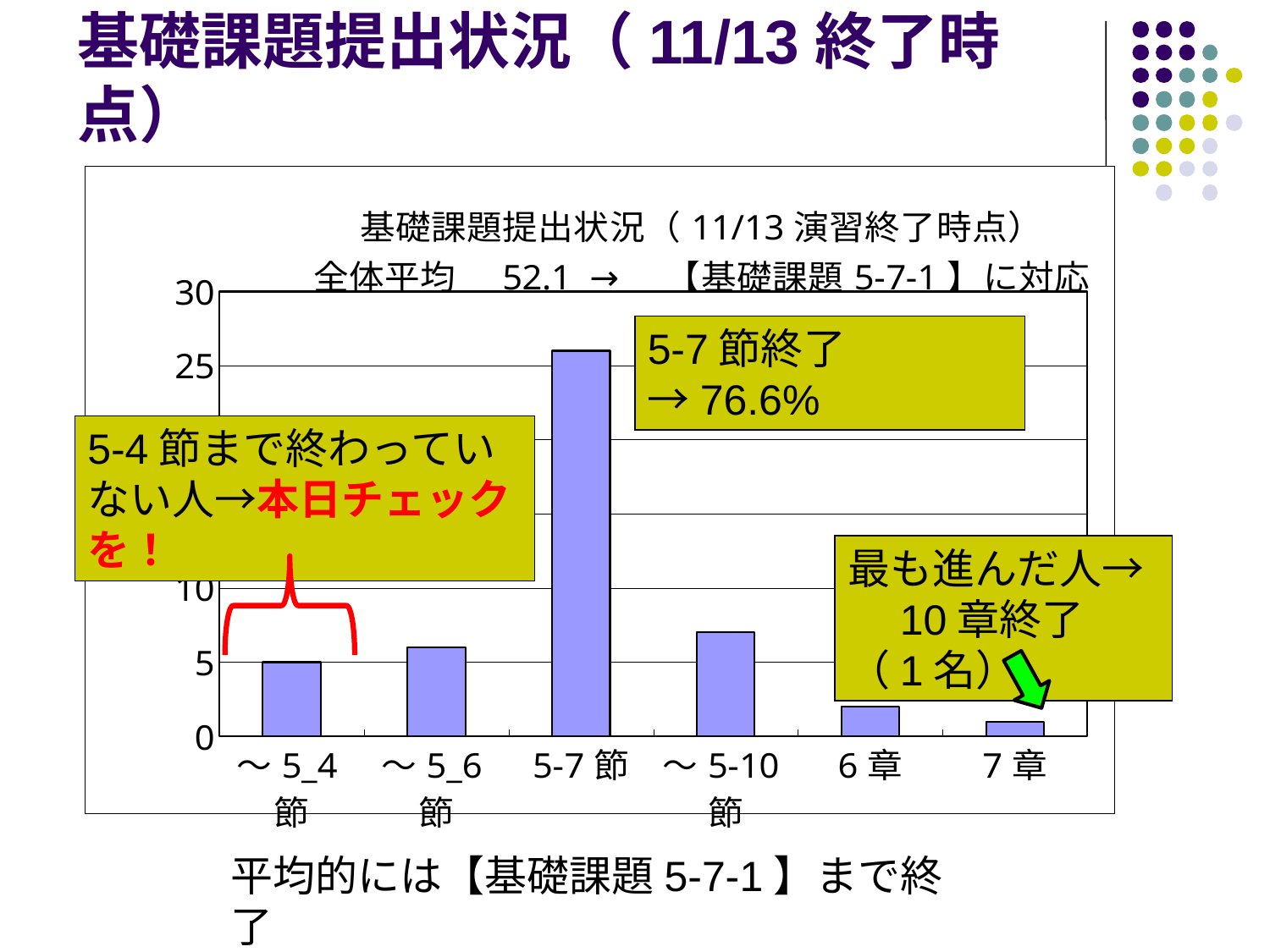
Is the value for 5-7節 greater or less than 25? greater Is the value for 7章 greater or less than 5? less Which category has the highest bar in the chart? 5-7節 Which is larger, the value for ～5_6節 or the value for 6章? ～5_6節 Is the value for 6章 greater or less than 5? less Which category has the lowest bar in the chart? 7章 What overall average (全体平均) value is stated in the chart's title area? 52.1 Which is larger, the value for 5-7節 or the value for ～5-10節? 5-7節 How many categories are shown on the x axis of the chart? 6 What kind of chart is shown on the slide? bar chart What is the title of the chart? 基礎課題提出状況（11/13演習終了時点）